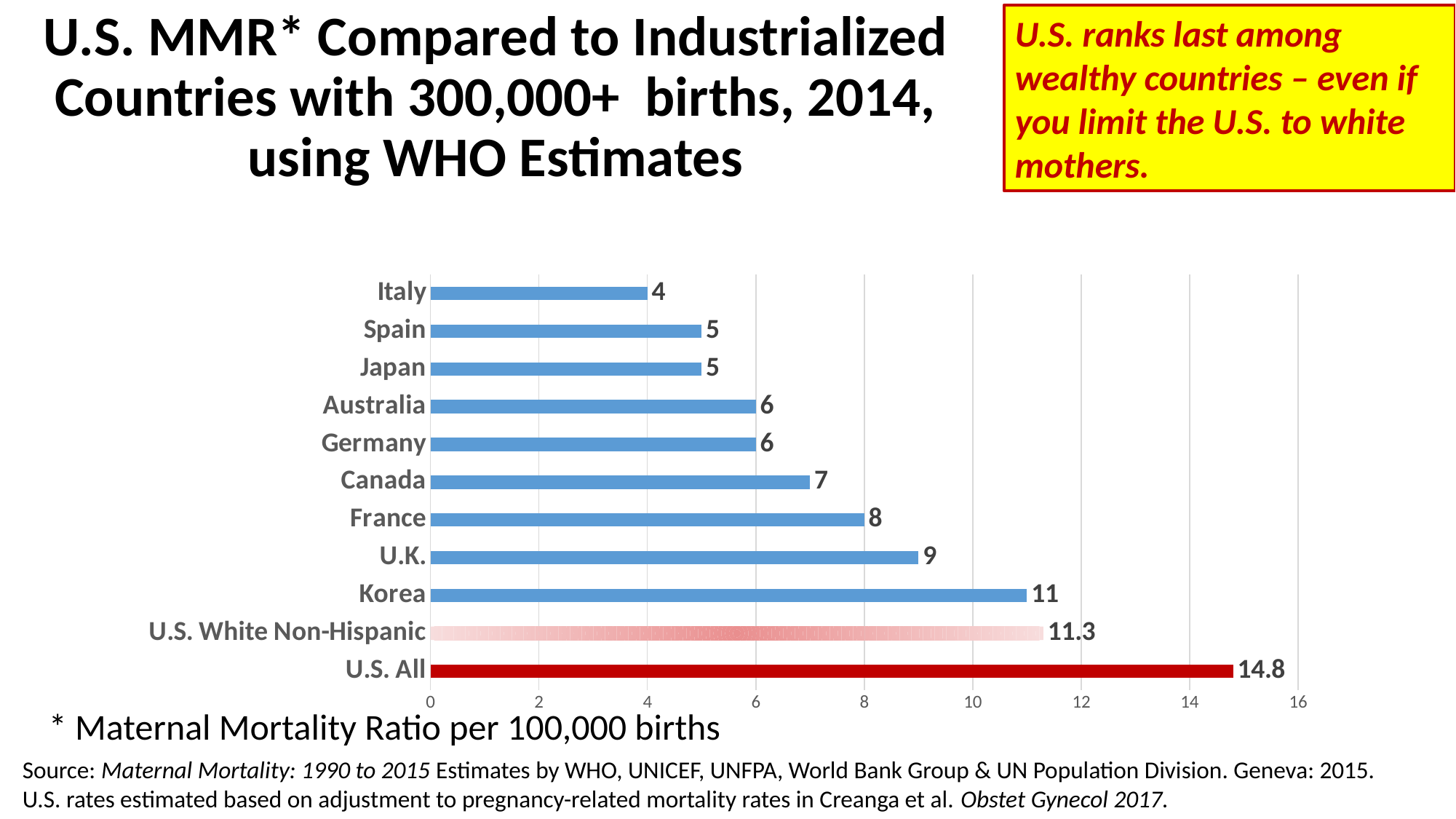
Which has a higher value, France or Australia? France What is the difference between the values for U.S. All and Korea? 3.8 What is the value shown for U.S. White Non-Hispanic? 11.3 How many categories (bars) are shown on the chart? 11 Is the value for U.S. All greater or less than 14? greater What type of chart is shown on the slide? Bar chart What is the value shown for Korea? 11 Which category has the highest maternal mortality ratio on the chart? U.S. All What is the difference between the values for U.K. and Italy? 5 What colour is the bar for U.S. All? Red What is the maternal mortality ratio shown for Canada? 7 Which country has the lowest maternal mortality ratio on the chart? Italy